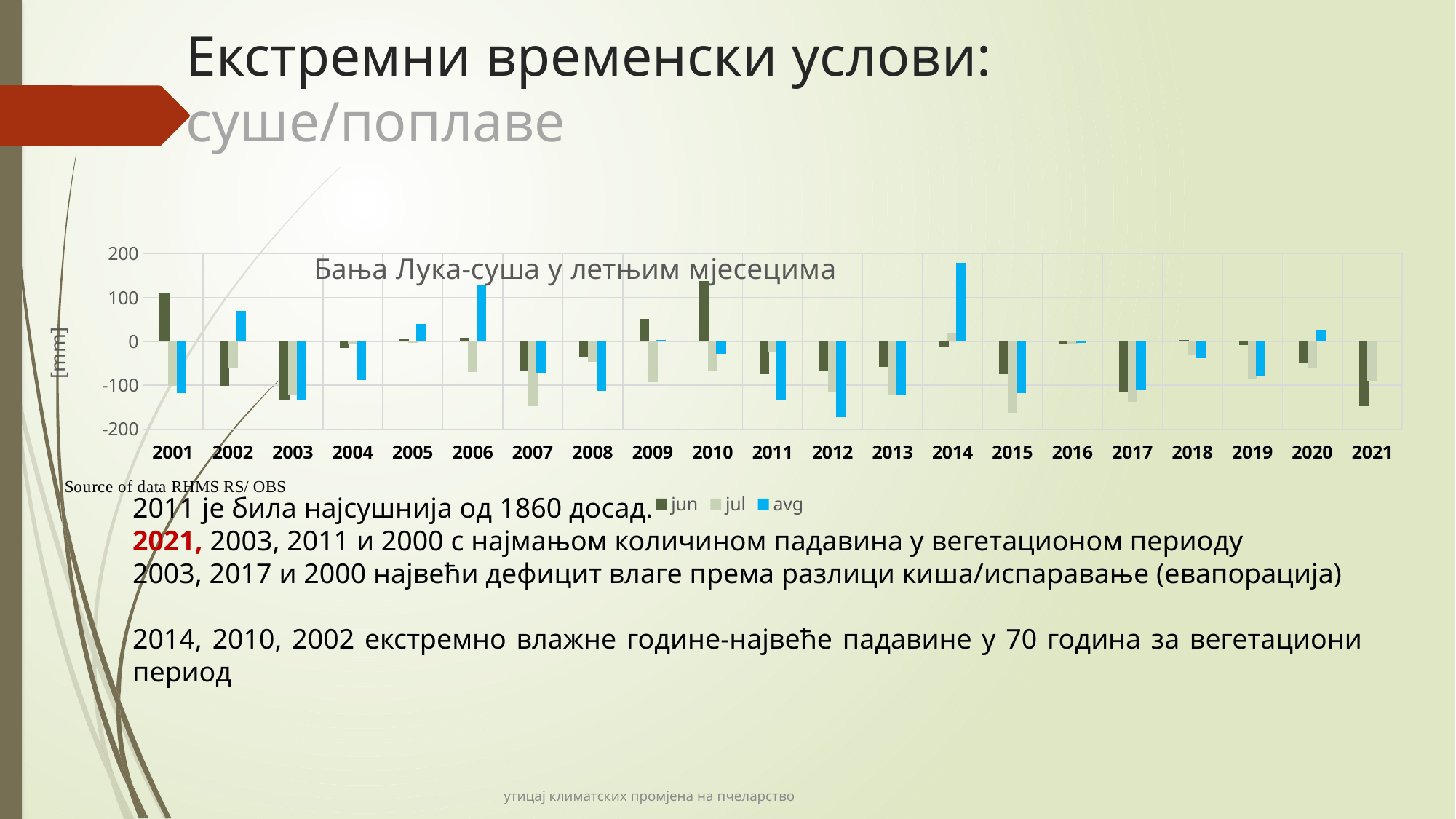
Is the avg value for 2014 greater or less than 100? greater In which year is the avg value lowest? 2012 How many series does the chart legend list? 3 What unit is shown on the y axis of the chart? [mm] Which is larger, the avg value for 2014 or the avg value for 2006? 2014 What kind of chart is shown on the slide? bar chart Is the jun value for 2001 greater or less than 100? greater What is the title of the chart? Бања Лука-суша у летњим мјесецима How many years are shown on the x axis of the chart? 21 Is the jul value for 2007 greater or less than -100? less In which year is the jun value highest? 2010 In which year is the avg value highest? 2014